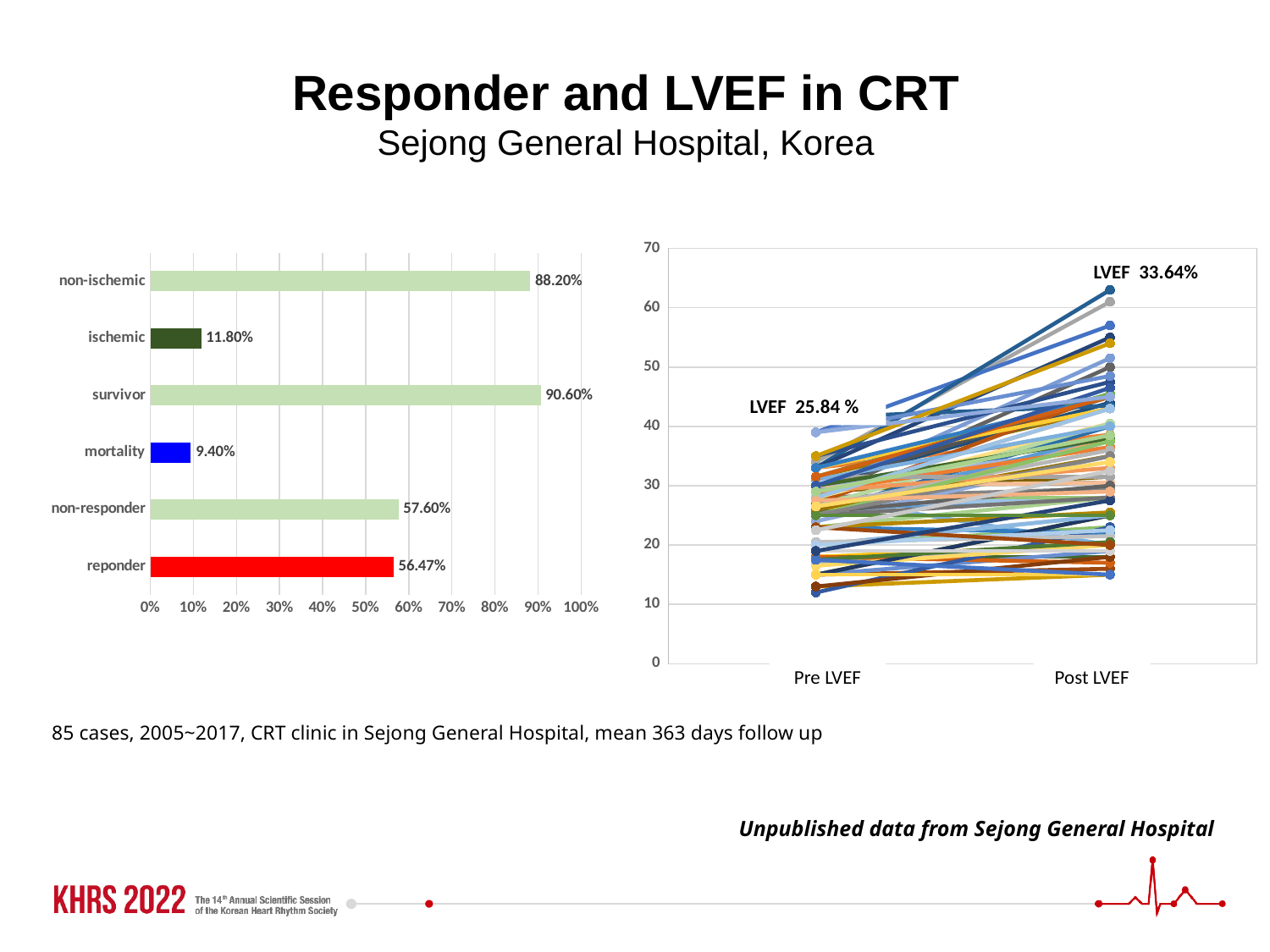
In the bar chart on the left, which is larger, the value for non-responder or the value for reponder? non-responder In the bar chart on the left, which category has the highest value? survivor In the bar chart on the left, what is the value for non-ischemic? 88.20% In the line chart on the right, what mean LVEF value is annotated at Pre LVEF? 25.84 % In the bar chart on the left, what is the difference between the non-ischemic and ischemic values? 76.40% In the line chart on the right, what mean LVEF value is annotated at Post LVEF? 33.64% In the bar chart on the left, what is the value for reponder? 56.47% In the bar chart on the left, which category has the lowest value? mortality In the bar chart on the left, what is the value for mortality? 9.40% What kind of chart is the chart on the left? bar chart In the bar chart on the left, how many categories are shown? 6 In the line chart on the right, what are the two x-axis categories? Pre LVEF and Post LVEF